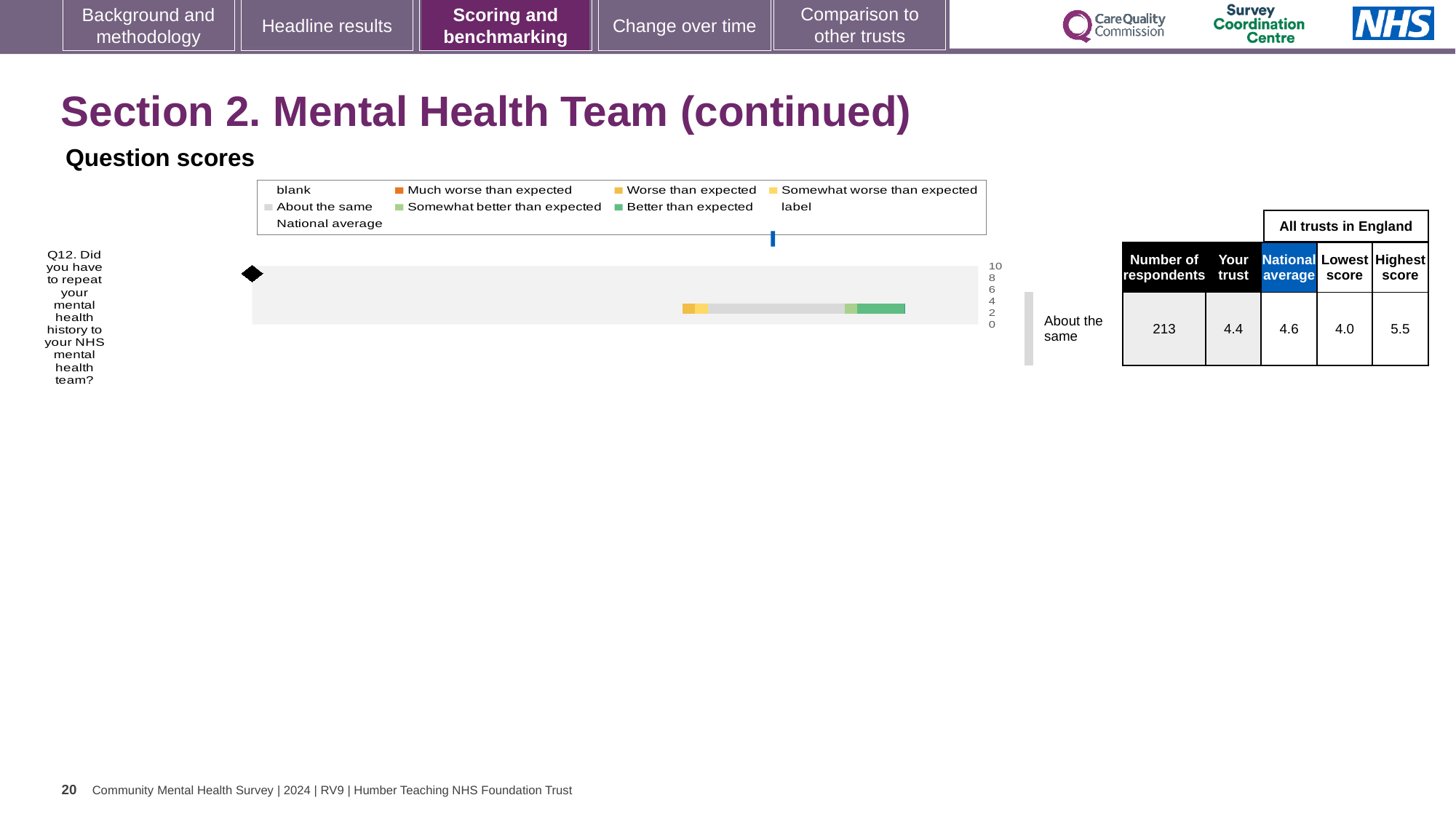
What is the highest score among all trusts in England for Q12? 5.5 In the chart legend, which category is shown in dark green? Better than expected What benchmark category is shown for Q12 in the Question scores chart? About the same How many respondents answered Q12? 213 What is the difference between the highest and lowest scores for Q12 across all trusts in England? 1.5 What is the 'Your trust' score for Q12 (repeating mental health history to the NHS mental health team)? 4.4 How many survey questions are plotted in the Question scores chart? 1 What is the lowest score among all trusts in England for Q12? 4.0 By how much does the national average exceed the 'Your trust' score for Q12? 0.2 For Q12, which is larger: the 'Your trust' score or the national average? National average What kind of chart is shown under 'Question scores'? bar chart What is the national average score for Q12? 4.6